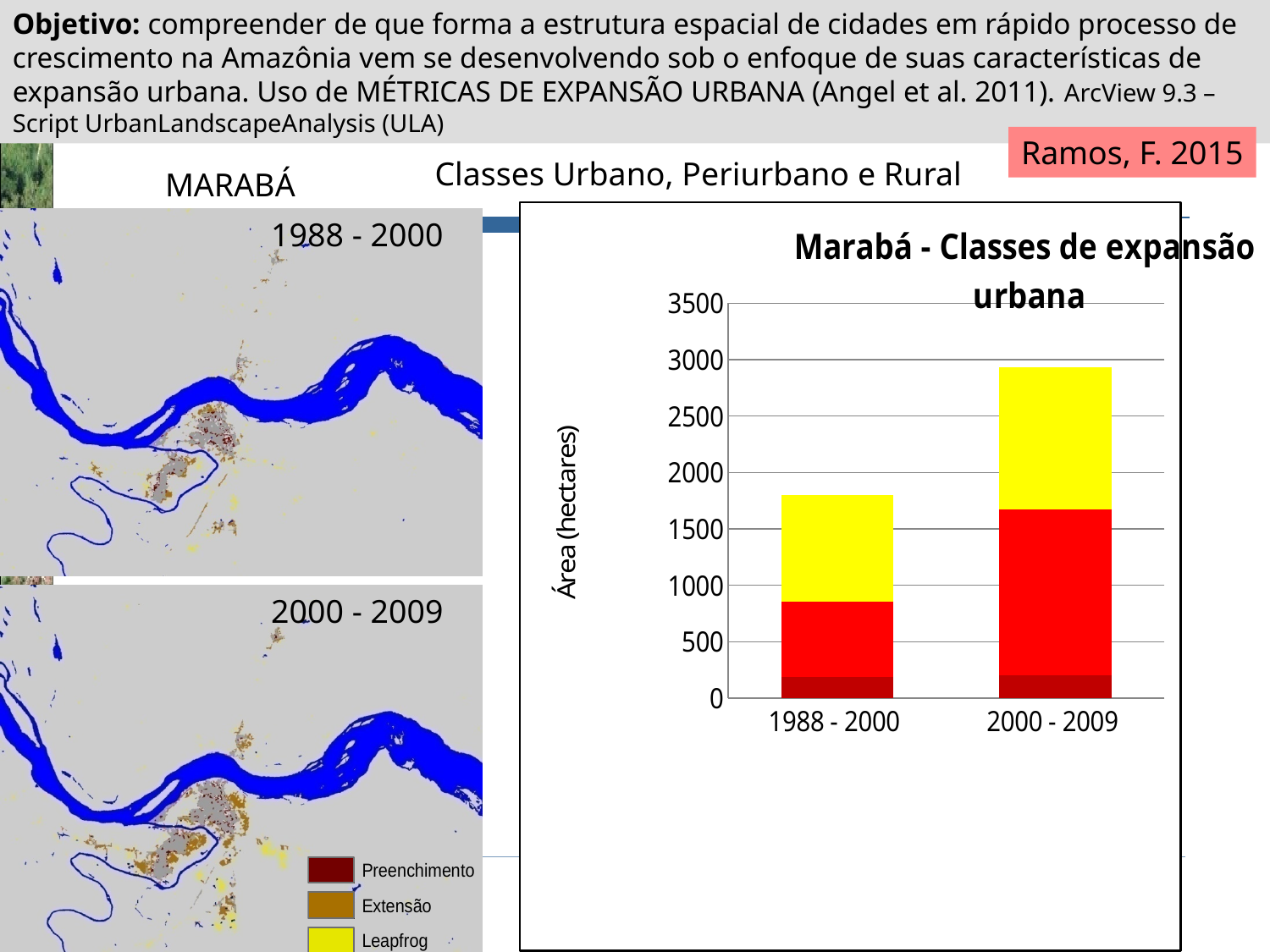
In the 'Marabá - Classes de expansão urbana' chart, does the total expansion area rise or fall from 1988 - 2000 to 2000 - 2009? rise In the 'Marabá - Classes de expansão urbana' chart, which period has the taller total bar? 2000 - 2009 What type of chart is shown in the 'Marabá - Classes de expansão urbana' chart? stacked bar chart In the 'Marabá - Classes de expansão urbana' chart, is the total area for 2000 - 2009 greater or less than 3500 hectares? less In the 'Marabá - Classes de expansão urbana' chart, is the total area for 2000 - 2009 greater or less than 2500 hectares? greater In the 'Marabá - Classes de expansão urbana' chart, which period has the shorter total bar? 1988 - 2000 What is the label of the vertical axis in the 'Marabá - Classes de expansão urbana' chart? Área (hectares) What is the title of the bar chart on the slide? Marabá - Classes de expansão urbana In the 'Marabá - Classes de expansão urbana' chart, is the total area for 1988 - 2000 greater or less than 1500 hectares? greater How many time-period categories are plotted on the x axis of the 'Marabá - Classes de expansão urbana' chart? 2 In the 'Marabá - Classes de expansão urbana' chart, is the red segment larger for 1988 - 2000 or for 2000 - 2009? 2000 - 2009